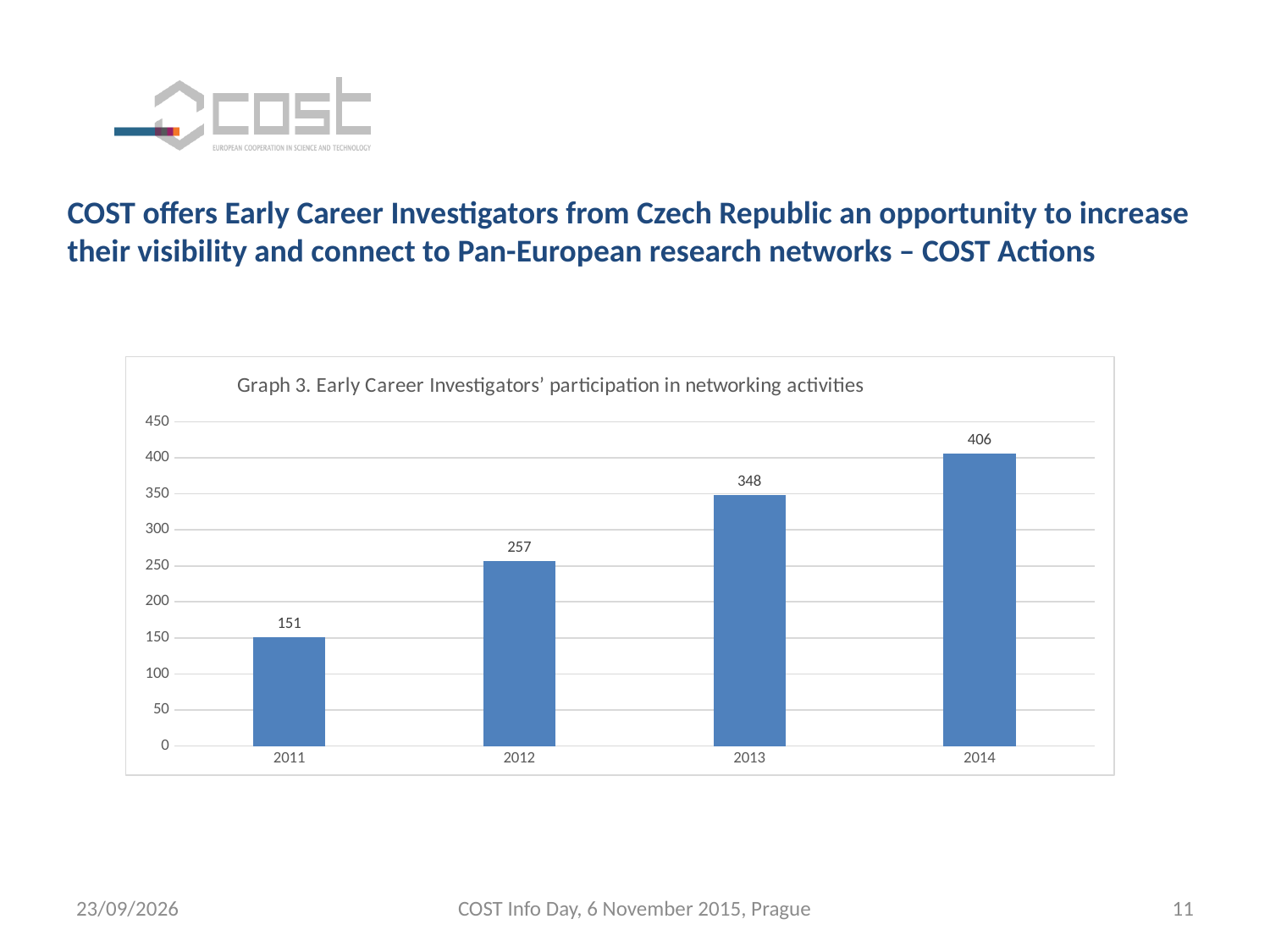
Which year has the lowest value? 2011 Which is larger, the value for 2012 or the value for 2013? 2013 How many years are shown on the x axis? 4 What kind of chart is shown? bar chart What is the difference between the values for 2014 and 2011? 255 What is the value for 2012? 257 Do the values rise or fall from 2011 to 2014? rise What is the value for 2014? 406 What is the difference between the values for 2013 and 2012? 91 What is the value for 2013? 348 Which year has the highest value? 2014 What is the value for 2011? 151